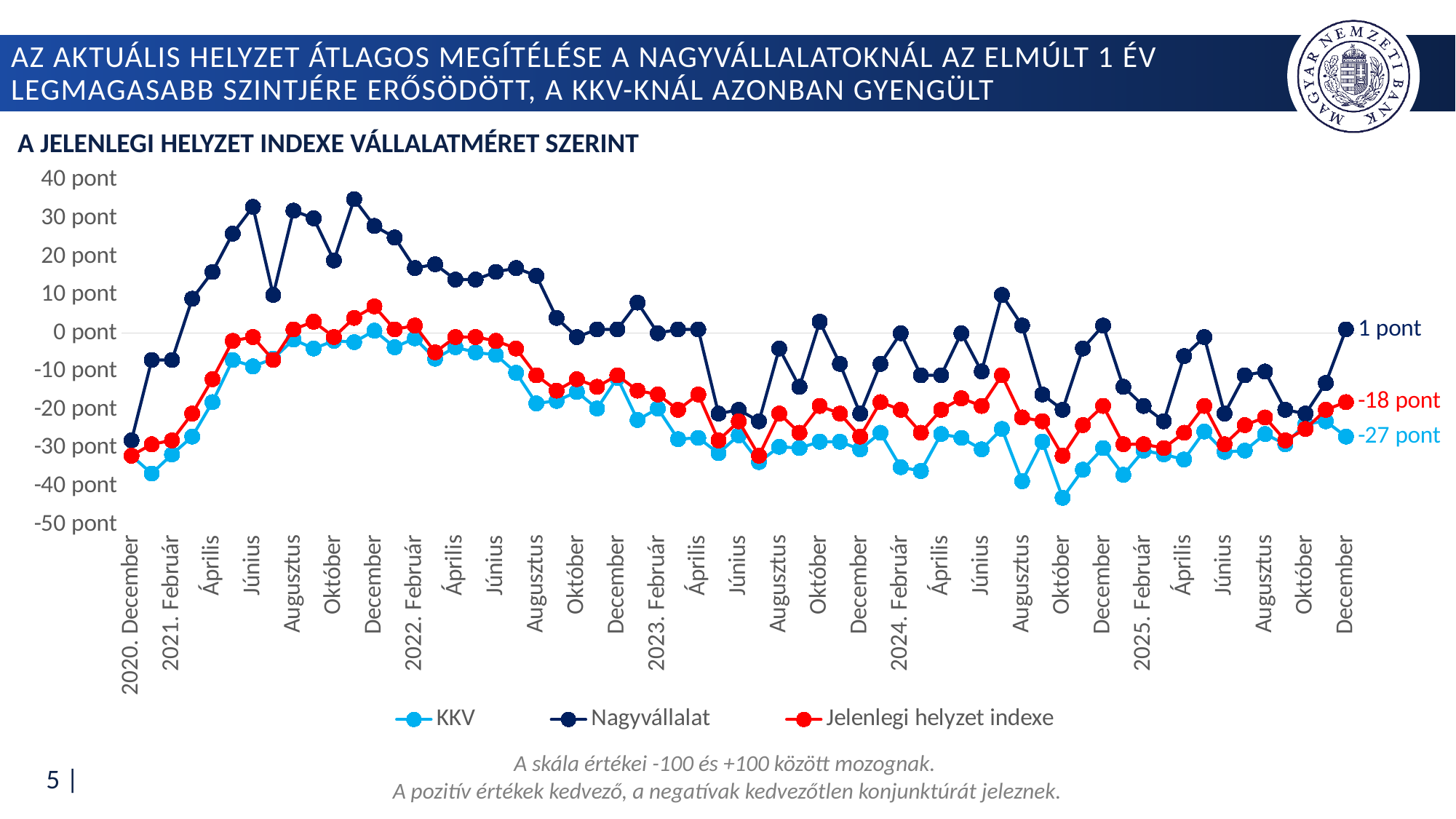
Which series has the highest value in 2025 December? Nagyvállalat How many series does the legend list? 3 In 2025 December, which is larger: the KKV value or the Nagyvállalat value? Nagyvállalat What is the value for Nagyvállalat in 2025 December? 1 pont What is the difference between the Jelenlegi helyzet indexe and KKV values in 2025 December? 9 pont What is the value for Jelenlegi helyzet indexe in 2025 December? -18 pont What is the difference between the Nagyvállalat and KKV values in 2025 December? 28 pont What is the value for KKV in 2025 December? -27 pont Which series has the lowest value in 2025 December? KKV What kind of chart is shown on the slide? line chart Is the value for KKV in 2024 October greater or less than -30 pont? less Is the value for Nagyvállalat in 2021 December greater or less than 30 pont? less